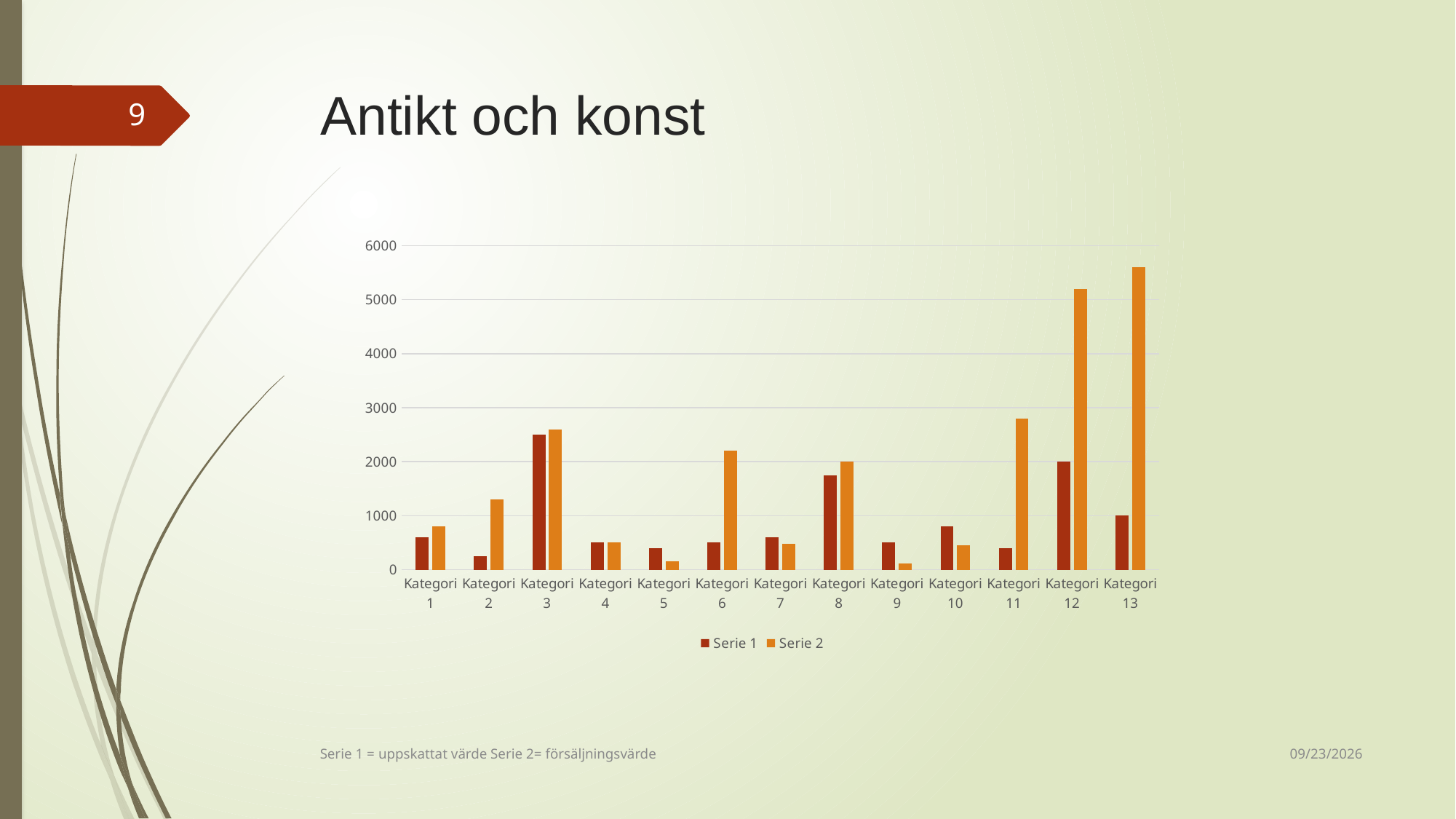
For Kategori 6, which series has the larger value, Serie 1 or Serie 2? Serie 2 What are the two entries listed in the chart legend? Serie 1 and Serie 2 Is the Serie 2 value for Kategori 11 greater or less than 3000? less Which category has the highest Serie 2 value? Kategori 13 Which category has the lowest Serie 1 value? Kategori 2 How many categories are shown on the x axis of the chart? 13 Which category has the highest Serie 1 value? Kategori 3 Is the Serie 1 value for Kategori 3 greater or less than 2000? greater For Kategori 10, which series has the larger value, Serie 1 or Serie 2? Serie 1 Is the Serie 2 value for Kategori 13 greater or less than 5000? greater What kind of chart is shown on the slide? bar chart How many series does the chart legend list? 2